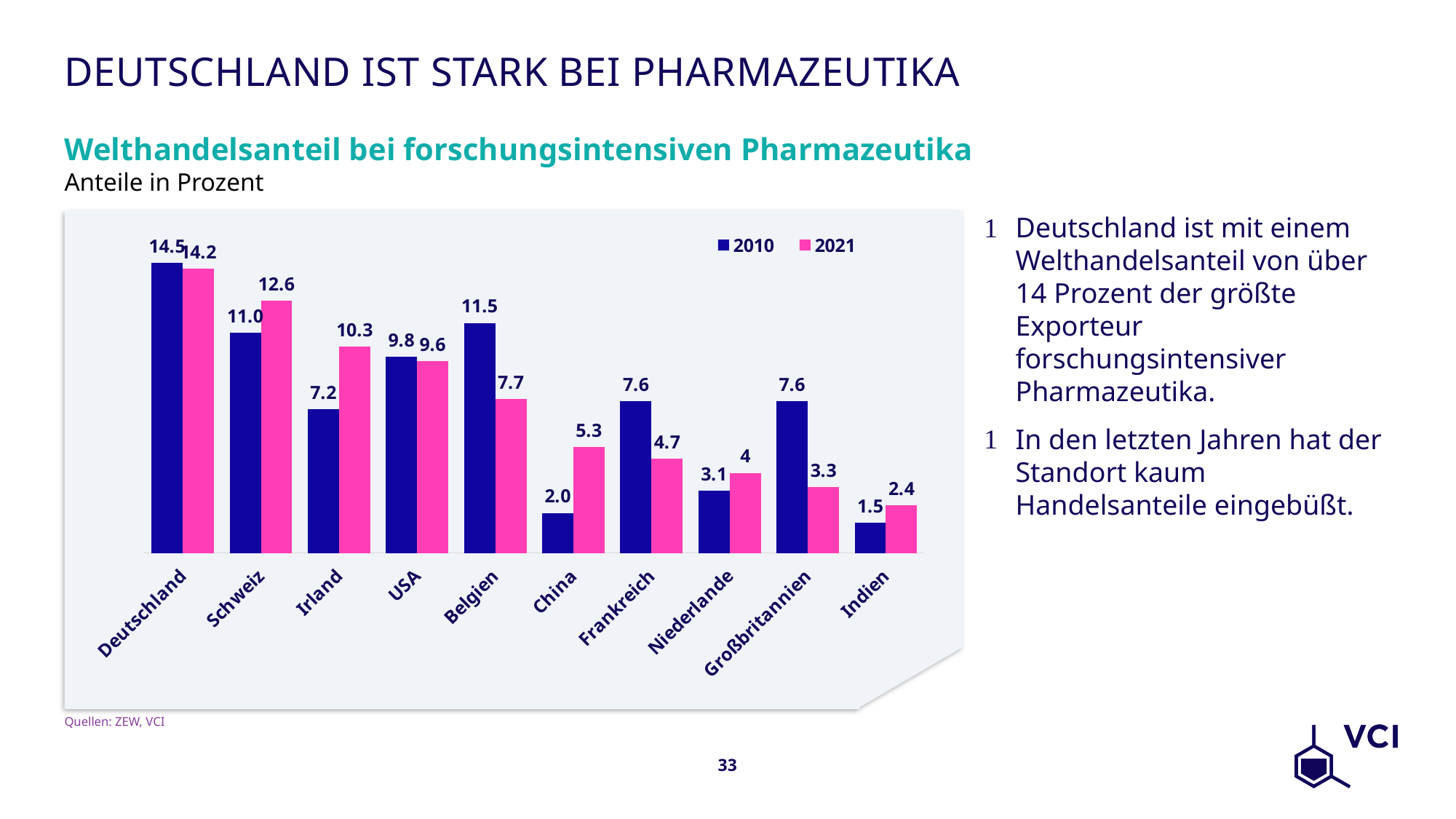
What is the difference between the 2010 and 2021 values for Großbritannien? 4.3 Which country has the lowest value in 2021? Indien What is the value for Deutschland in 2021? 14.2 What kind of chart is shown? bar chart How many series does the legend list? 2 What is the value for Schweiz in 2010? 11.0 Which colour represents the 2021 series? pink What is the value for Irland in 2021? 10.3 Which is larger for Belgien: the 2010 value or the 2021 value? 2010 Which country has the highest value in 2010? Deutschland How many countries are shown on the x axis? 10 What is the value for Niederlande in 2021? 4